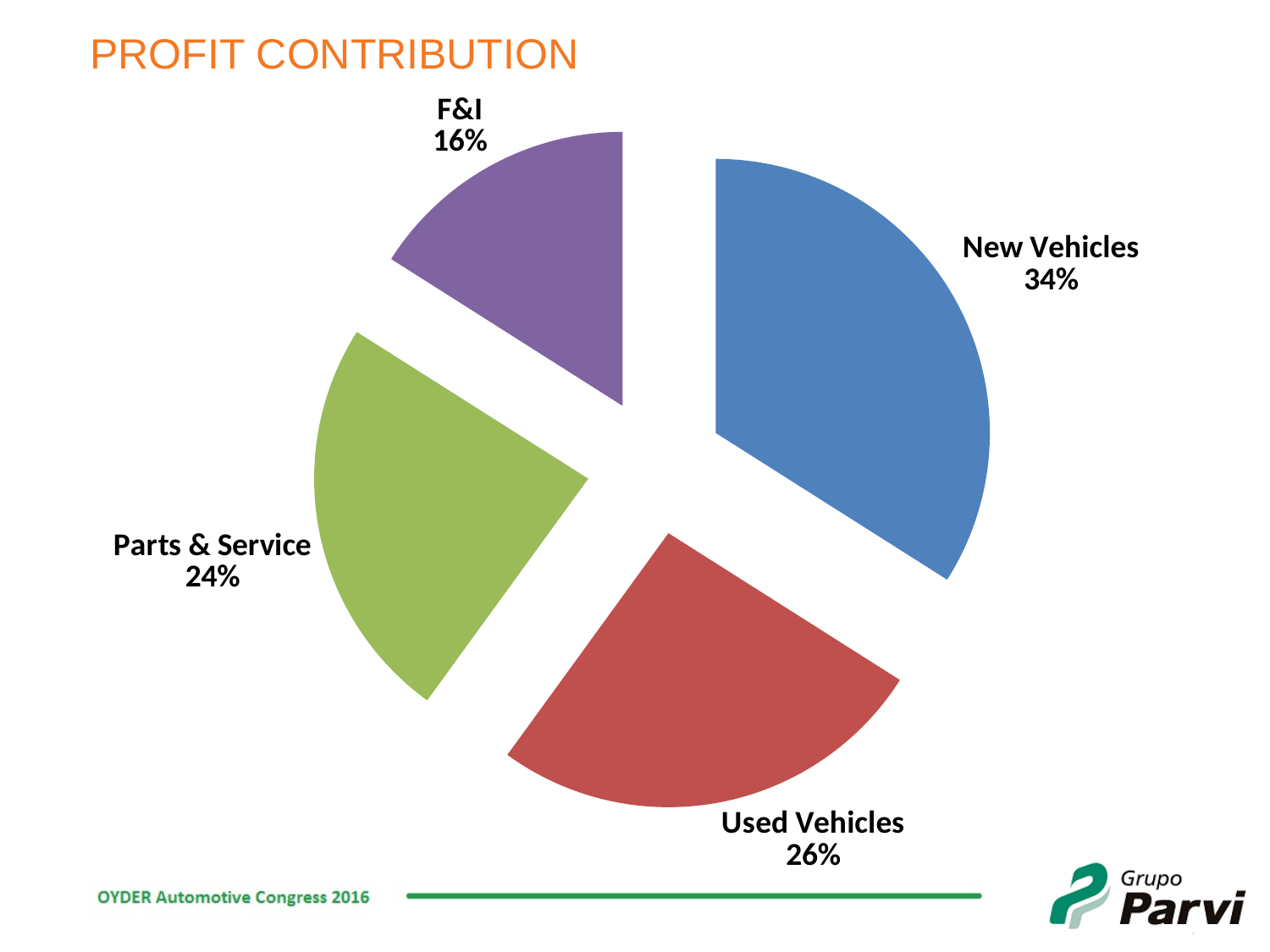
What is the combined share of New Vehicles and Used Vehicles? 60% Which category has the largest share of profit contribution? New Vehicles What share of profit contribution comes from F&I? 16% What is the title of the chart on the slide? PROFIT CONTRIBUTION What is the difference in percentage points between New Vehicles and F&I? 18 What kind of chart is shown on the slide? pie chart What share of profit contribution comes from Parts & Service? 24% Which category has the smallest share of profit contribution? F&I Which is larger, the share for Used Vehicles or the share for Parts & Service? Used Vehicles What share of profit contribution comes from New Vehicles? 34% How many categories are shown in the pie chart? 4 What share of profit contribution comes from Used Vehicles? 26%